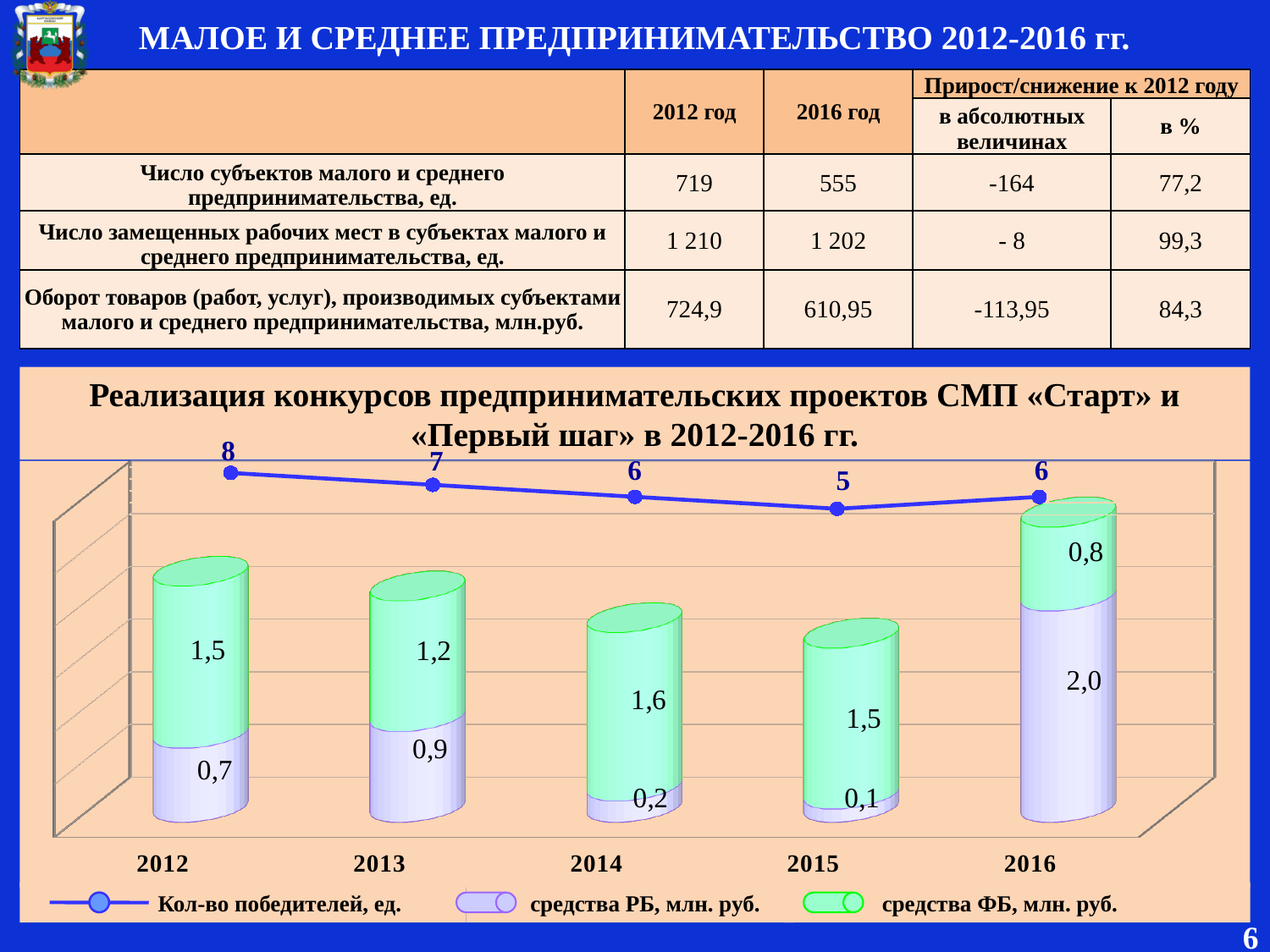
Does the number of winners rise or fall from 2012 to 2015? Fall What is the value of средства ФБ, млн. руб. for 2014? 1,6 How many series does the chart legend list? 3 What is the value of средства РБ, млн. руб. for 2016? 2,0 In which year is the number of winners (Кол-во победителей) lowest? 2015 What is the total of средства РБ and средства ФБ for 2016? 2,8 How many years are shown on the x axis of the chart? 5 Which is larger in 2015: средства РБ or средства ФБ? средства ФБ In which year is средства РБ, млн. руб. highest? 2016 What kind of chart is shown on the slide? Combined stacked bar and line chart How many winners (Кол-во победителей) does the chart show for 2012? 8 What is the difference between средства ФБ in 2014 and средства ФБ in 2013? 0,4